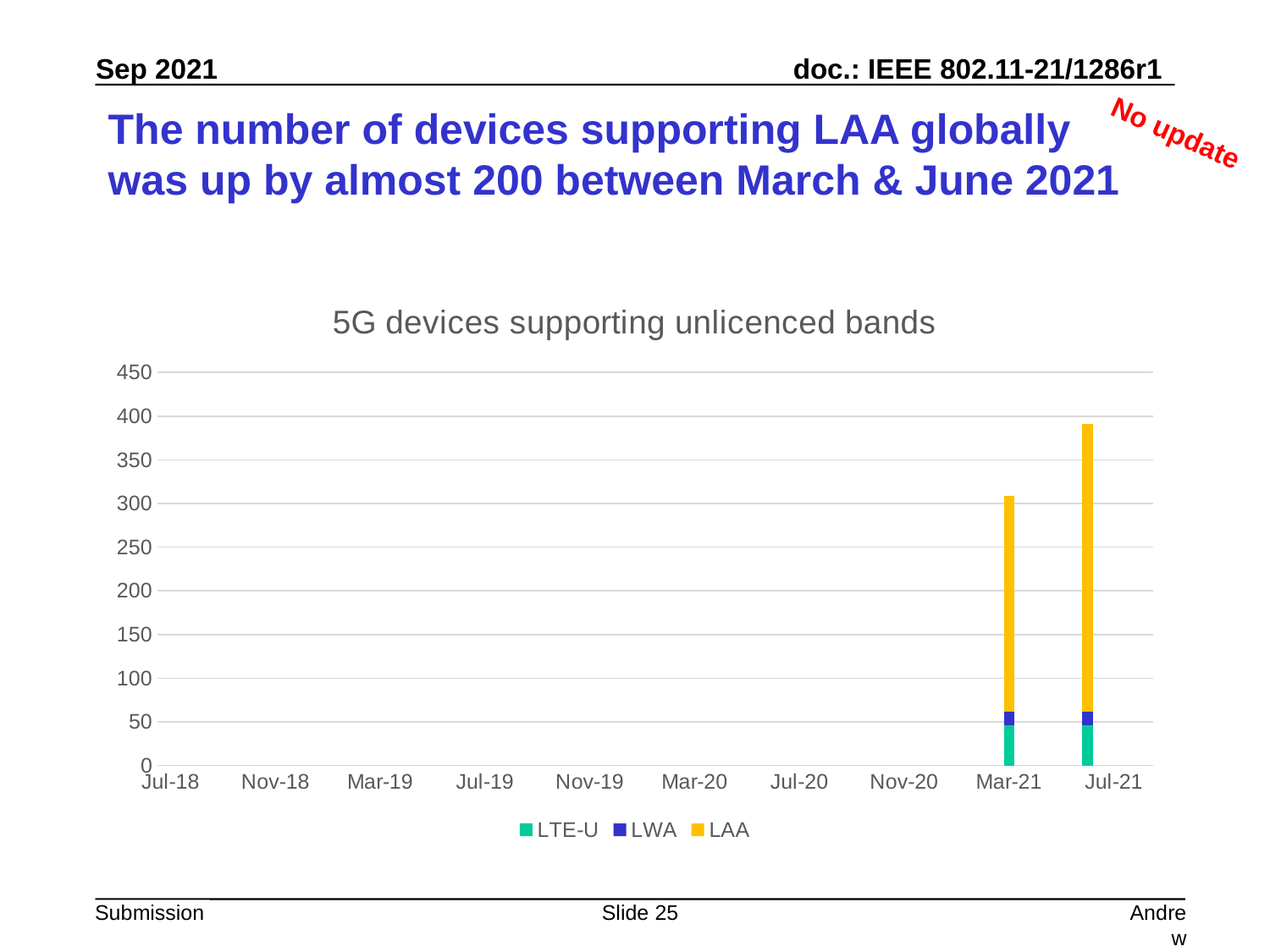
Is the total stacked value for Jul-21 greater or less than 350? greater How many series does the legend list? 3 Is the total stacked value for Mar-21 greater or less than 350? less Which series are listed in the legend? LTE-U, LWA, LAA What kind of chart is shown on the slide? stacked bar chart Which series makes up the largest part of the Jul-21 bar? LAA How many date labels are shown along the x axis? 10 Is the total stacked value for Mar-21 greater or less than 250? greater Which series makes up the smallest part of the Mar-21 bar? LWA Which has the larger total stacked value, Mar-21 or Jul-21? Jul-21 Do the total stacked values rise or fall from Mar-21 to Jul-21? rise What is the title of the chart? 5G devices supporting unlicenced bands